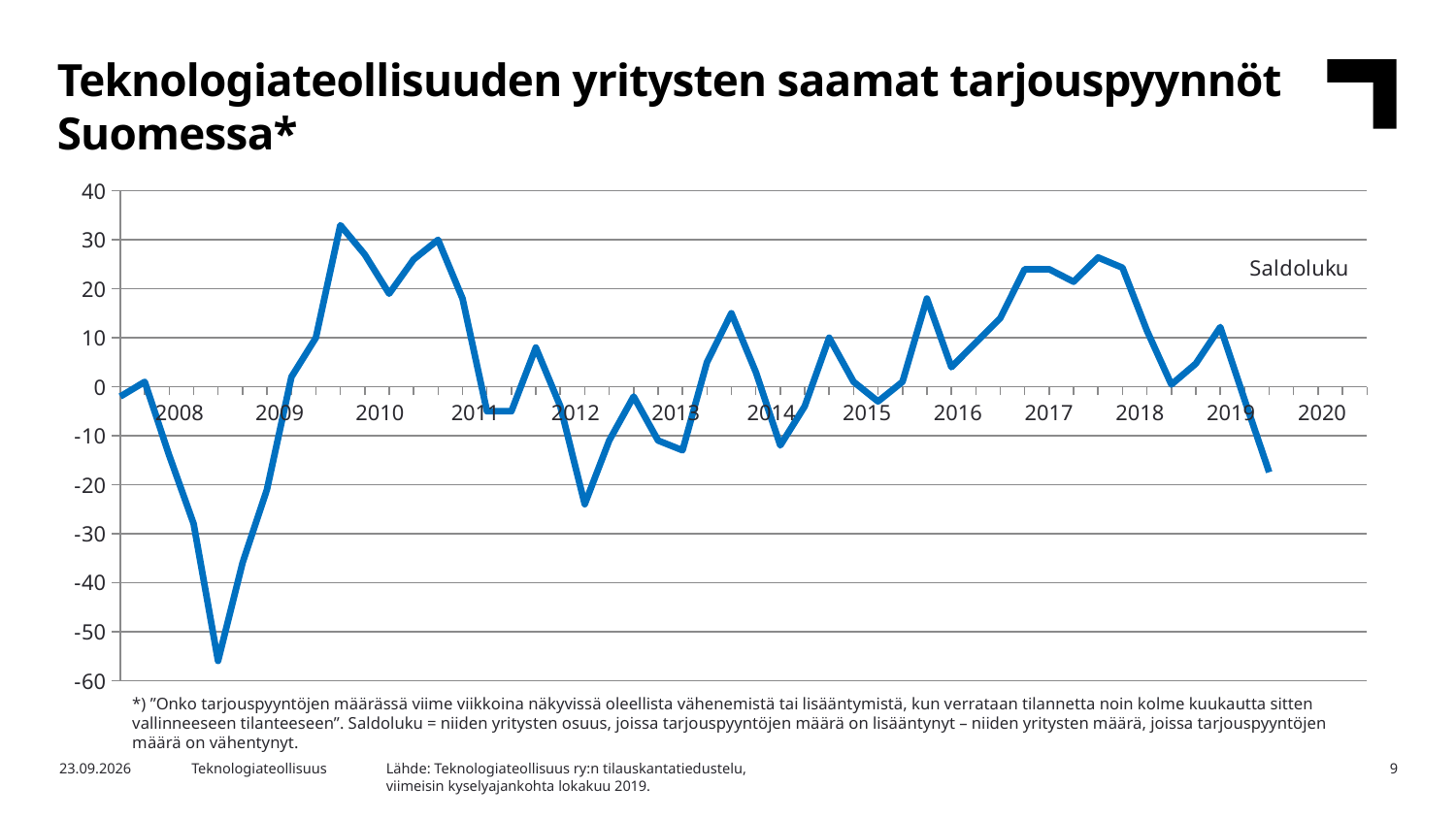
How many year labels are shown on the x axis? 13 What is the name of the series plotted in the chart? Saldoluku Is the lowest value of the line greater or less than -50? less What kind of chart is shown on the slide? line chart What is the title of the chart on the slide? Teknologiateollisuuden yritysten saamat tarjouspyynnöt Suomessa* Does the lowest point of the line occur before or after 2010? before Is the last plotted value at the end of the line (after 2019) greater or less than -10? less How many series does the chart show? 1 Is the lowest value of the line around 2012 greater or less than -20? less Does the line rise or fall between 2018 and the end of 2019? fall